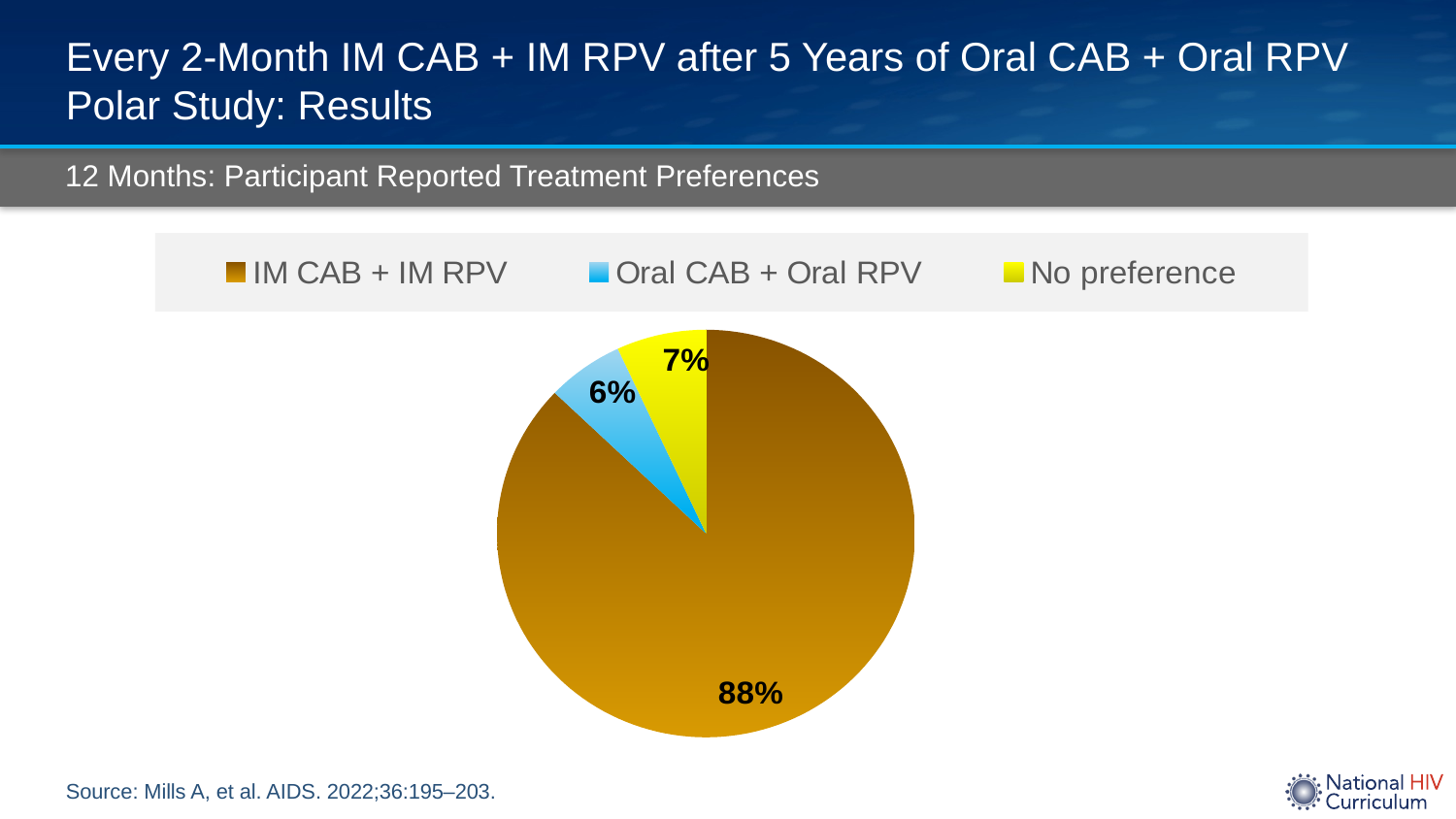
What type of chart is shown on the slide? Pie chart Which category has the smallest share of the pie? Oral CAB + Oral RPV How many categories are shown in the pie chart? 3 What percentage of participants preferred IM CAB + IM RPV? 88% What is the difference in percentage points between IM CAB + IM RPV and Oral CAB + Oral RPV? 82 What is the subtitle describing the chart's content? 12 Months: Participant Reported Treatment Preferences What percentage of participants preferred Oral CAB + Oral RPV? 6% Which is larger: the share for No preference or the share for Oral CAB + Oral RPV? No preference What colour represents No preference in the pie chart? Yellow How many entries does the legend list? 3 What percentage of participants reported no preference? 7% Which treatment preference category has the largest share of the pie? IM CAB + IM RPV